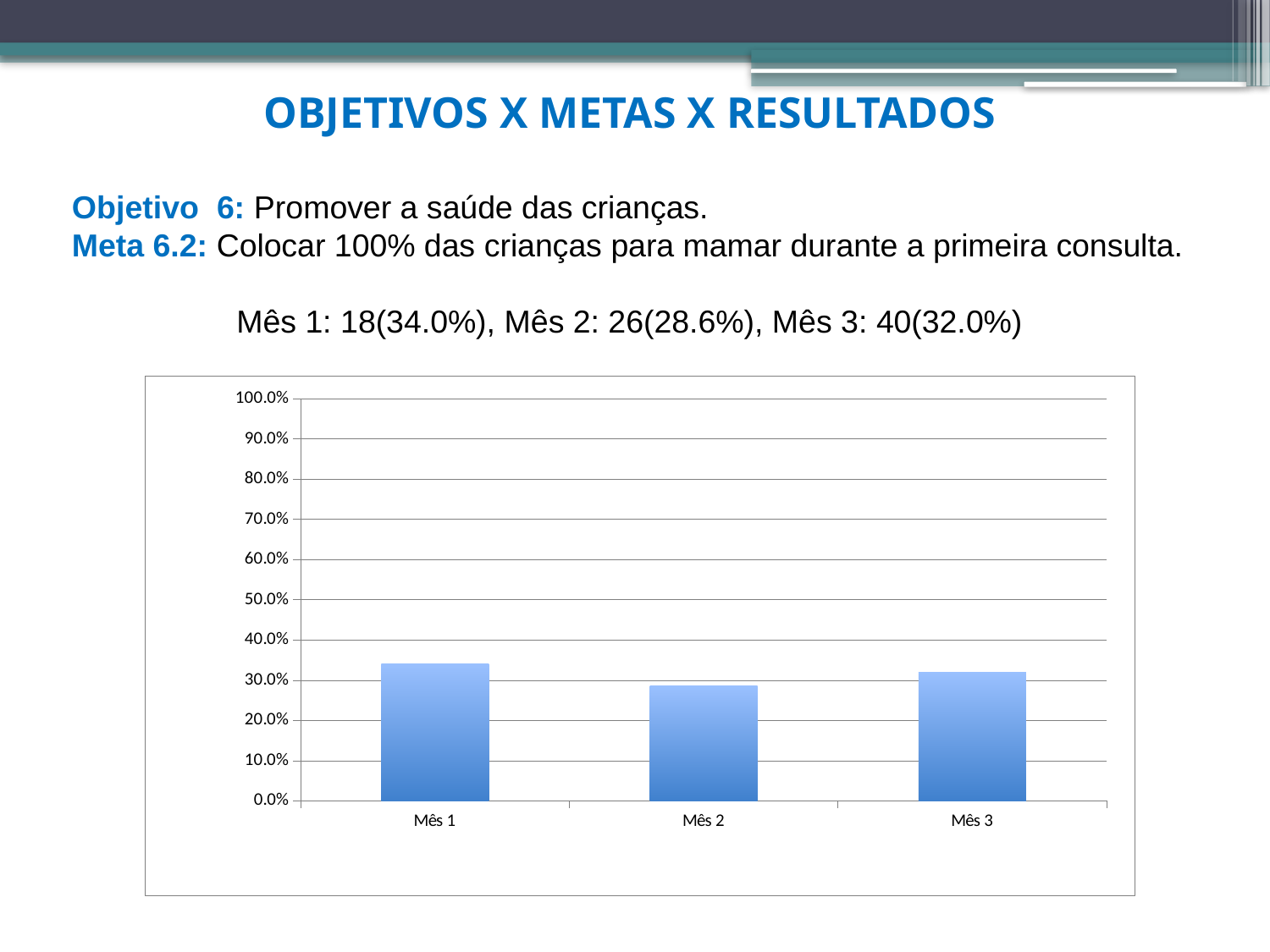
How many categories are shown on the x axis? 3 What is the value for Mês 2? 28.6% What is the highest value shown on the y axis? 100.0% What kind of chart is shown on the slide? bar chart What is the value for Mês 1? 34.0% Which month has the highest value? Mês 1 Which month has the lowest value? Mês 2 Is the value for Mês 2 greater or less than 30.0%? less Is the value for Mês 3 greater or less than 40.0%? less Which is larger, the value for Mês 2 or the value for Mês 3? Mês 3 What is the difference between the values for Mês 1 and Mês 2? 5.4% What is the value for Mês 3? 32.0%